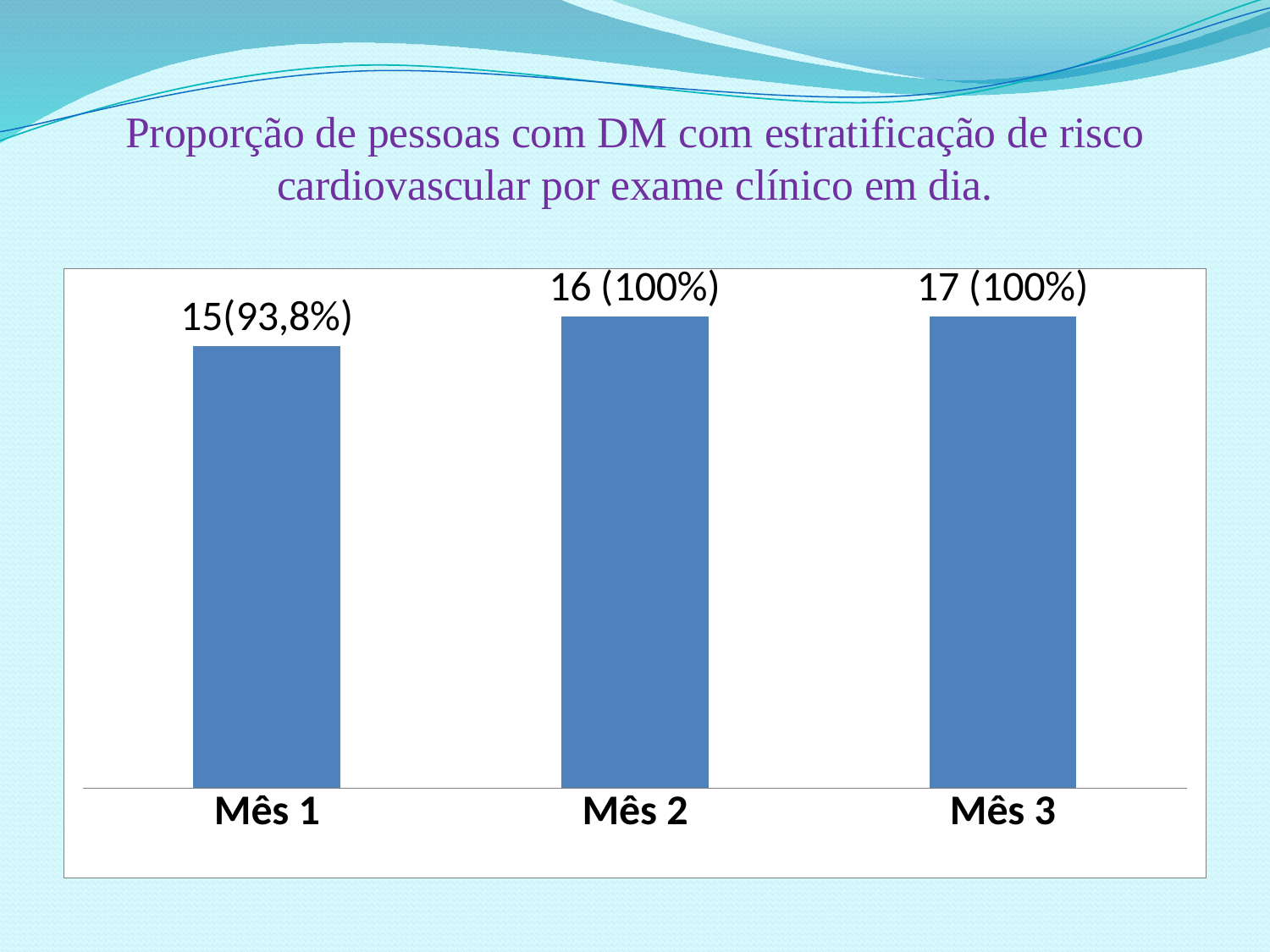
How many months (categories) are shown on the x axis? 3 What percentage is shown for Mês 1? 93,8% What is the data label shown for Mês 1? 15(93,8%) What is the data label shown for Mês 2? 16 (100%) What is the difference between the counts for Mês 3 and Mês 2? 1 Which month has the lowest bar? Mês 1 What is the difference between the counts for Mês 2 and Mês 1? 1 What kind of chart is shown on the slide? Bar chart Does the value rise or fall from Mês 1 to Mês 2? Rise Which is larger, the bar for Mês 1 or the bar for Mês 2? Mês 2 What is the title of the slide above the chart? Proporção de pessoas com DM com estratificação de risco cardiovascular por exame clínico em dia. What is the data label shown for Mês 3? 17 (100%)